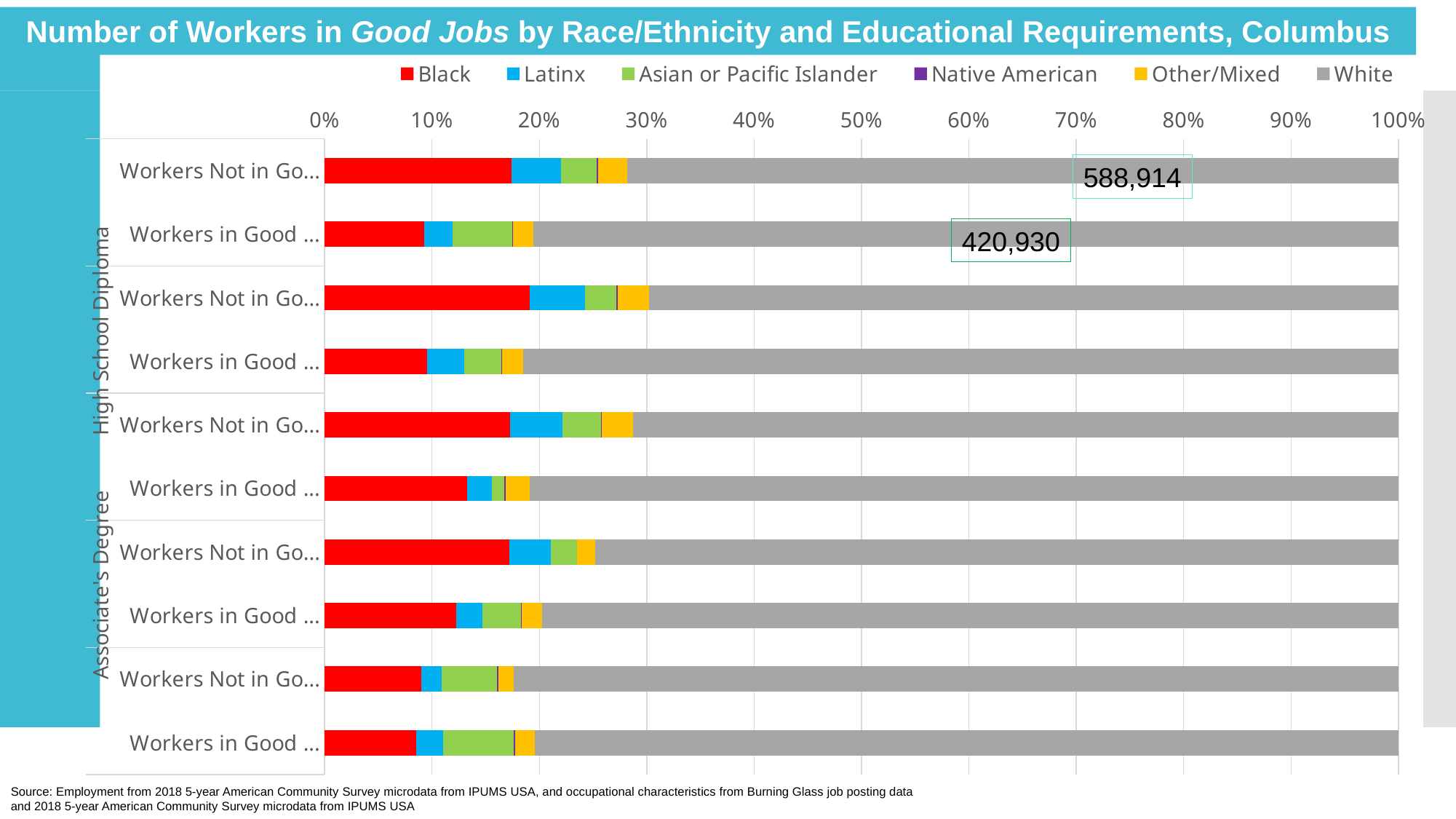
Which colour represents the Black series in the legend? Red How many bars are plotted in the chart? 10 In the second bar from the top, is the Black segment greater or less than 20%? less Which series takes up the largest share in every bar? White What number is shown in the text box next to the second bar from the top? 420,930 How many series does the legend list? 6 What kind of chart is shown on the slide? Stacked bar chart Is the Black segment larger in the topmost bar or in the second bar from the top? Topmost bar What is the highest value shown on the x axis? 100% What number is shown in the text box next to the topmost bar? 588,914 In the topmost bar, is the Black segment greater or less than 10%? greater What is the title of the chart? Number of Workers in Good Jobs by Race/Ethnicity and Educational Requirements, Columbus